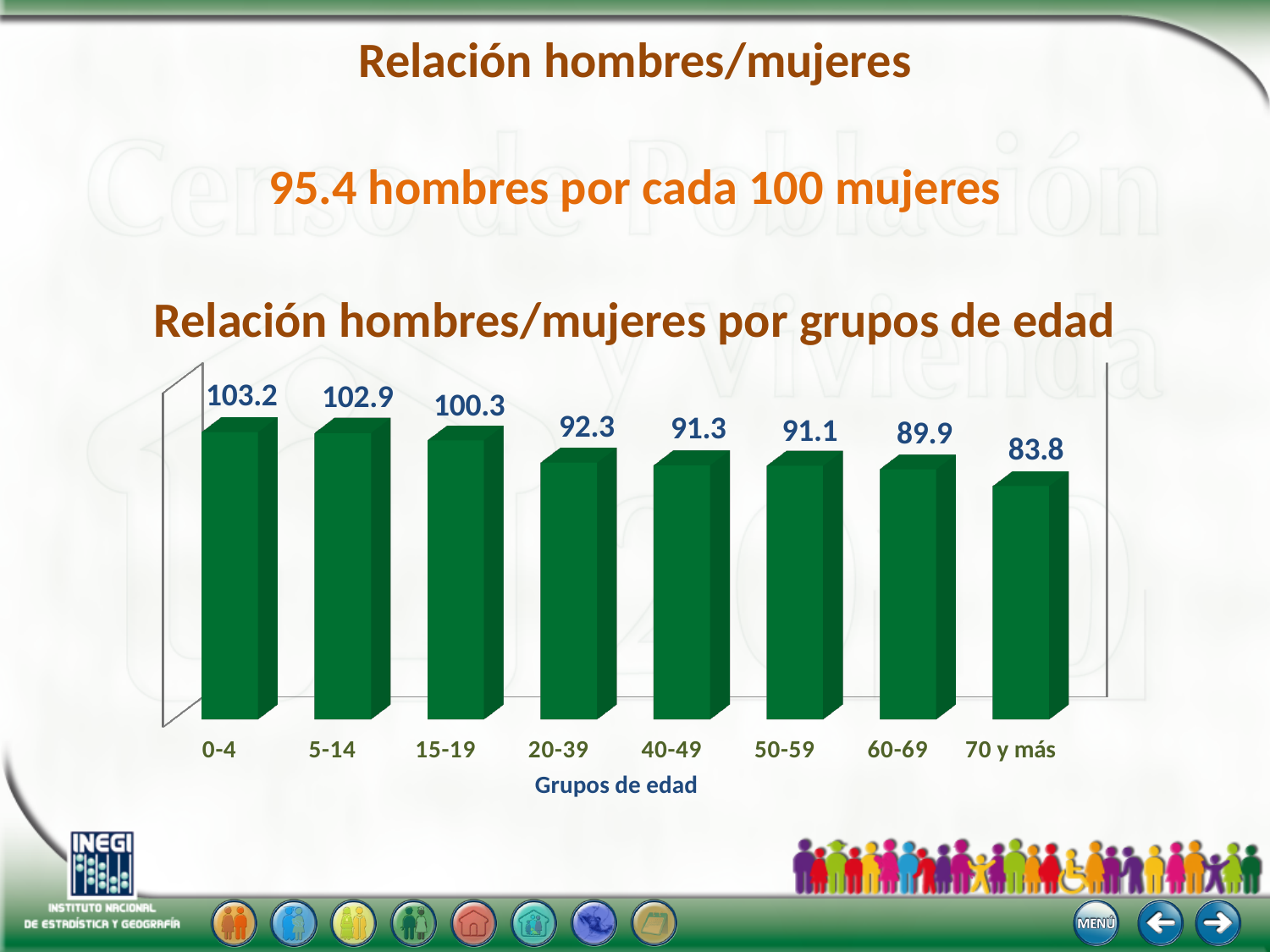
What is the title of the chart? Relación hombres/mujeres por grupos de edad What is the value for the 70 y más age group? 83.8 Which is larger, the value for 40-49 or the value for 60-69? 40-49 What is the value for the 20-39 age group? 92.3 What is the difference between the values for 0-4 and 70 y más? 19.4 What is the value for the 0-4 age group? 103.2 Which age group has the lowest value? 70 y más What kind of chart is shown? bar chart Do the values rise or fall as age group increases along the x axis? fall What is the difference between the values for 15-19 and 20-39? 8.0 Which age group has the highest value? 0-4 How many age groups are shown on the x axis? 8